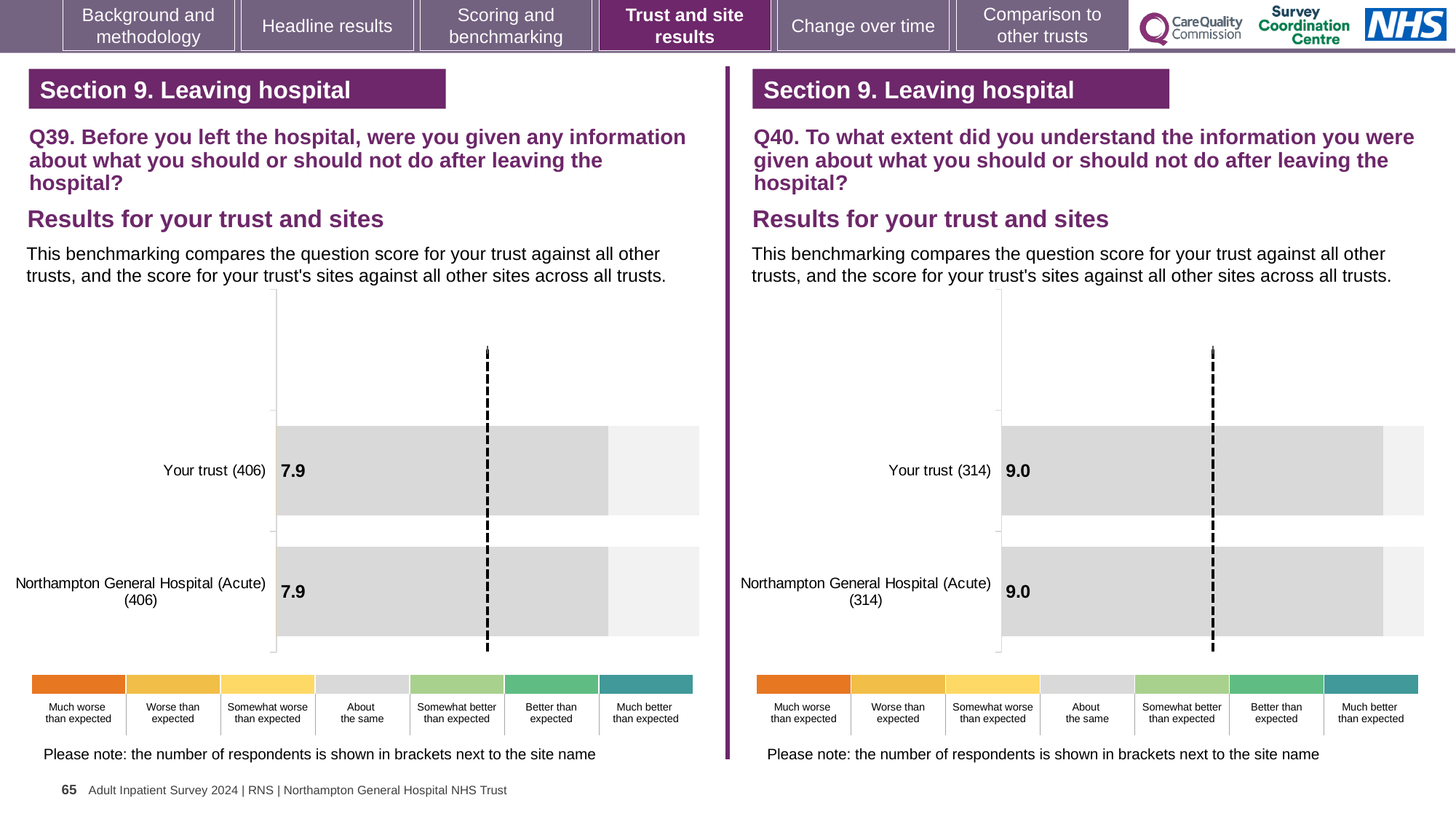
In the Q39 chart on the left, what is the score for Your trust? 7.9 In the Q39 chart on the left, what is the difference between the score for Your trust and the score for Northampton General Hospital (Acute)? 0.0 In the Q40 chart on the right, how many respondents are shown in brackets for Northampton General Hospital (Acute)? 314 In the Q39 chart on the left, what is the score for Northampton General Hospital (Acute)? 7.9 In the Q40 chart on the right, what is the score for Northampton General Hospital (Acute)? 9.0 What kind of chart is used for the Q40 results on the right? Bar chart In the Q39 chart on the left, how many respondents are shown in brackets for Your trust? 406 How many bars are plotted in the Q39 chart on the left? 2 In the Q40 chart on the right, what is the score for Your trust? 9.0 How many benchmark categories are listed in the colour key below the Q39 chart on the left? 7 In the Q40 chart on the right, is the score for Your trust larger than, smaller than, or equal to the score for Northampton General Hospital (Acute)? equal How many bars are plotted in the Q40 chart on the right? 2